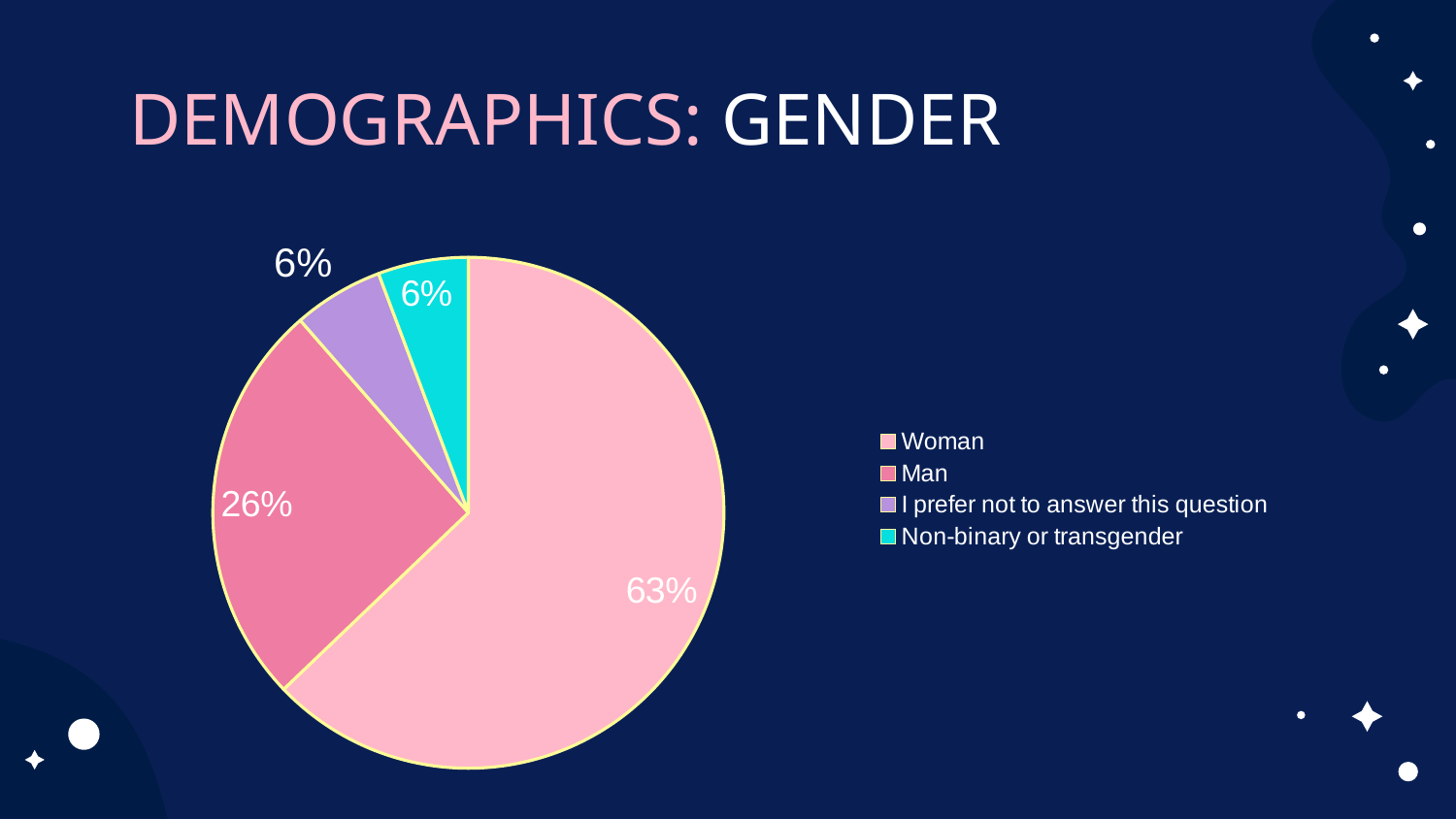
Which is larger, the Man slice or the Non-binary or transgender slice? Man Which category has the largest share of the pie? Woman What percentage of respondents chose 'I prefer not to answer this question'? 6% What percentage of respondents identified as Woman? 63% What percentage of respondents identified as Man? 26% What colour is the slice representing Non-binary or transgender? Cyan What percentage of respondents chose 'Non-binary or transgender'? 6% What kind of chart is shown on the slide? Pie chart What is the difference in percentage points between the Woman and Man slices? 37 How many categories does the legend list? 4 What is the title of the slide containing the chart? DEMOGRAPHICS: GENDER What is the combined percentage of the Man and Woman slices? 89%